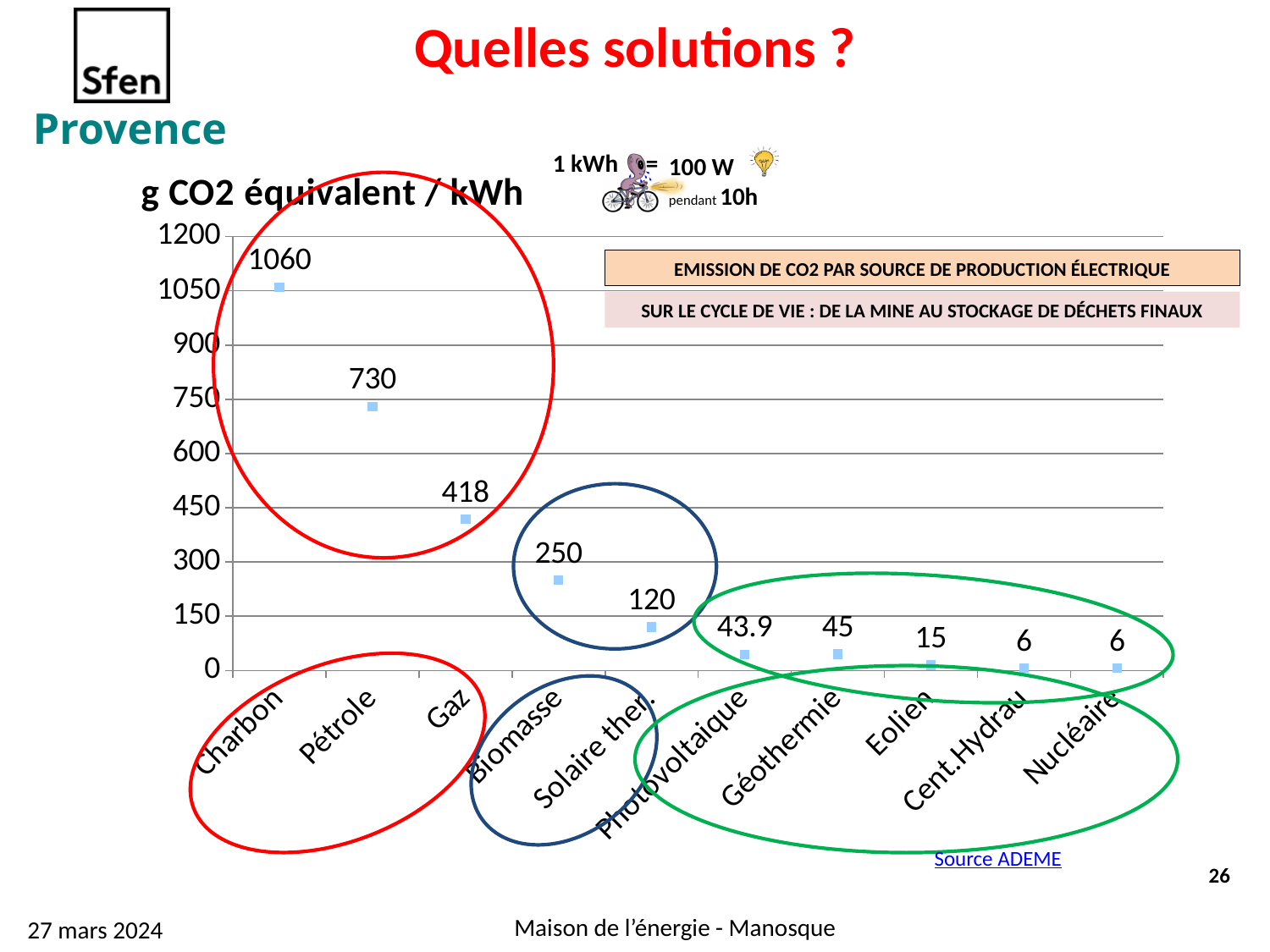
What is the value for Biomasse? 250 Which is larger, the value for Gaz or the value for Biomasse? Gaz What is the value for Charbon? 1060 What is the difference between the values for Biomasse and Solaire ther.? 130 Do the values generally rise or fall from left to right along the x axis? fall What is the value for Nucléaire? 6 What is the difference between the values for Charbon and Pétrole? 330 Is the value for Pétrole greater or less than 600? greater Which category has the highest value? Charbon How many categories are shown on the x axis? 10 What is the value for Photovoltaique? 43.9 What is the value for Gaz? 418